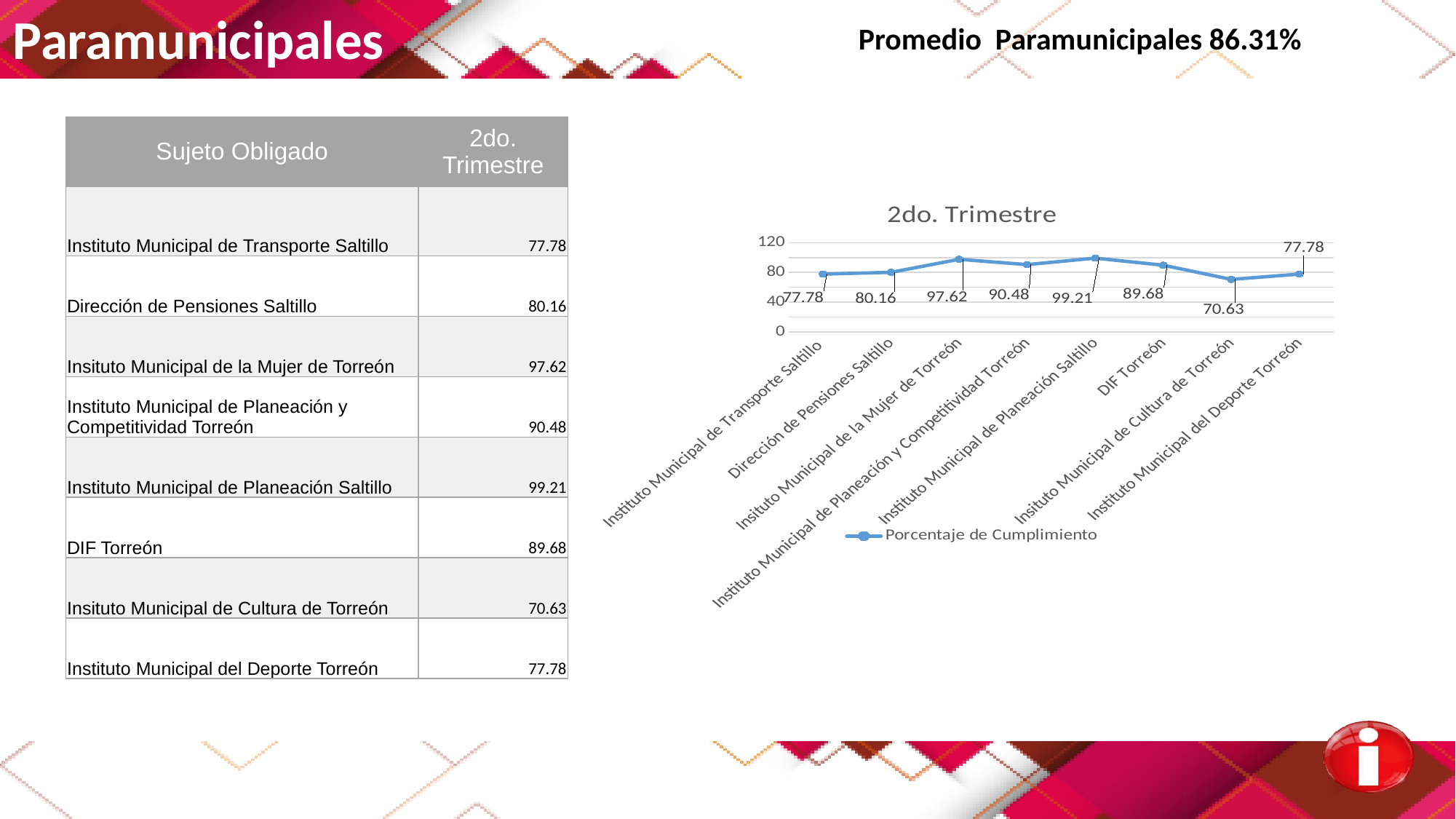
What is the title of the chart? 2do. Trimestre Which category has the lowest value in the chart? Insituto Municipal de Cultura de Torreón How many categories are plotted on the x axis of the chart? 8 What type of chart is shown on the slide? line chart How many series does the chart legend list? 1 What is the difference between the values for Insituto Municipal de la Mujer de Torreón and Dirección de Pensiones Saltillo? 17.46 What is the value for Insituto Municipal de Cultura de Torreón in the chart? 70.63 What is the value for Instituto Municipal de Planeación Saltillo in the chart? 99.21 What is the value for DIF Torreón in the chart? 89.68 What is the name of the series shown in the chart legend? Porcentaje de Cumplimiento Which is larger: the value for Instituto Municipal de Planeación y Competitividad Torreón or the value for DIF Torreón? Instituto Municipal de Planeación y Competitividad Torreón Which category has the highest value in the chart? Instituto Municipal de Planeación Saltillo